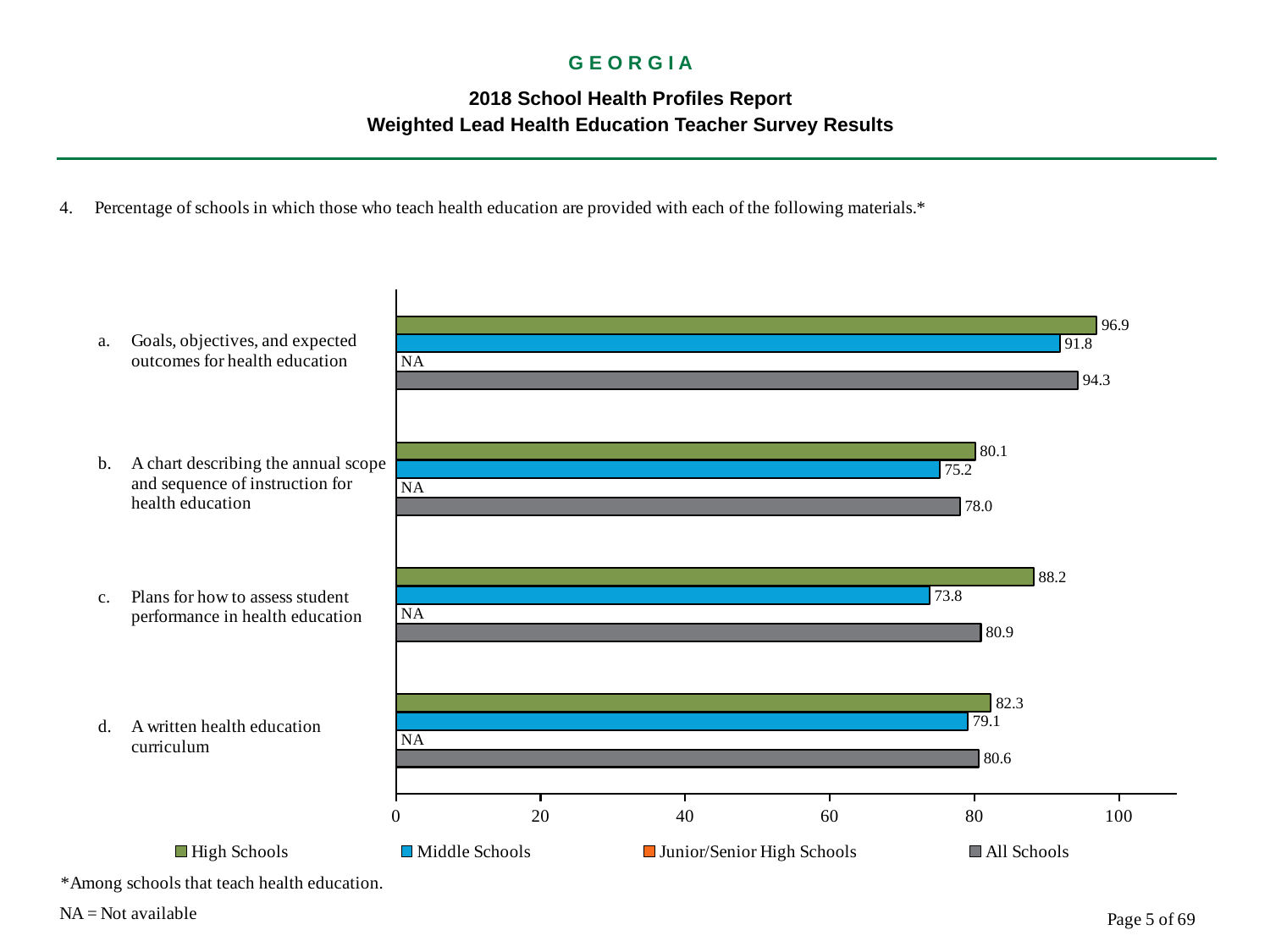
What kind of chart is shown on the slide? Bar chart What is the difference between the High Schools and Middle Schools values for 'Plans for how to assess student performance in health education'? 14.4 Which is larger for 'A written health education curriculum': the High Schools value or the All Schools value? High Schools What is the All Schools value for 'A written health education curriculum'? 80.6 What is the High Schools value for 'Goals, objectives, and expected outcomes for health education'? 96.9 How many series does the legend list? 4 How many materials (categories) are shown on the chart? 4 Which material has the highest High Schools value? Goals, objectives, and expected outcomes for health education What is the Middle Schools value for 'Plans for how to assess student performance in health education'? 73.8 Which material has the lowest Middle Schools value? Plans for how to assess student performance in health education What is the Middle Schools value for 'A chart describing the annual scope and sequence of instruction for health education'? 75.2 What value is shown for Junior/Senior High Schools in each category? NA